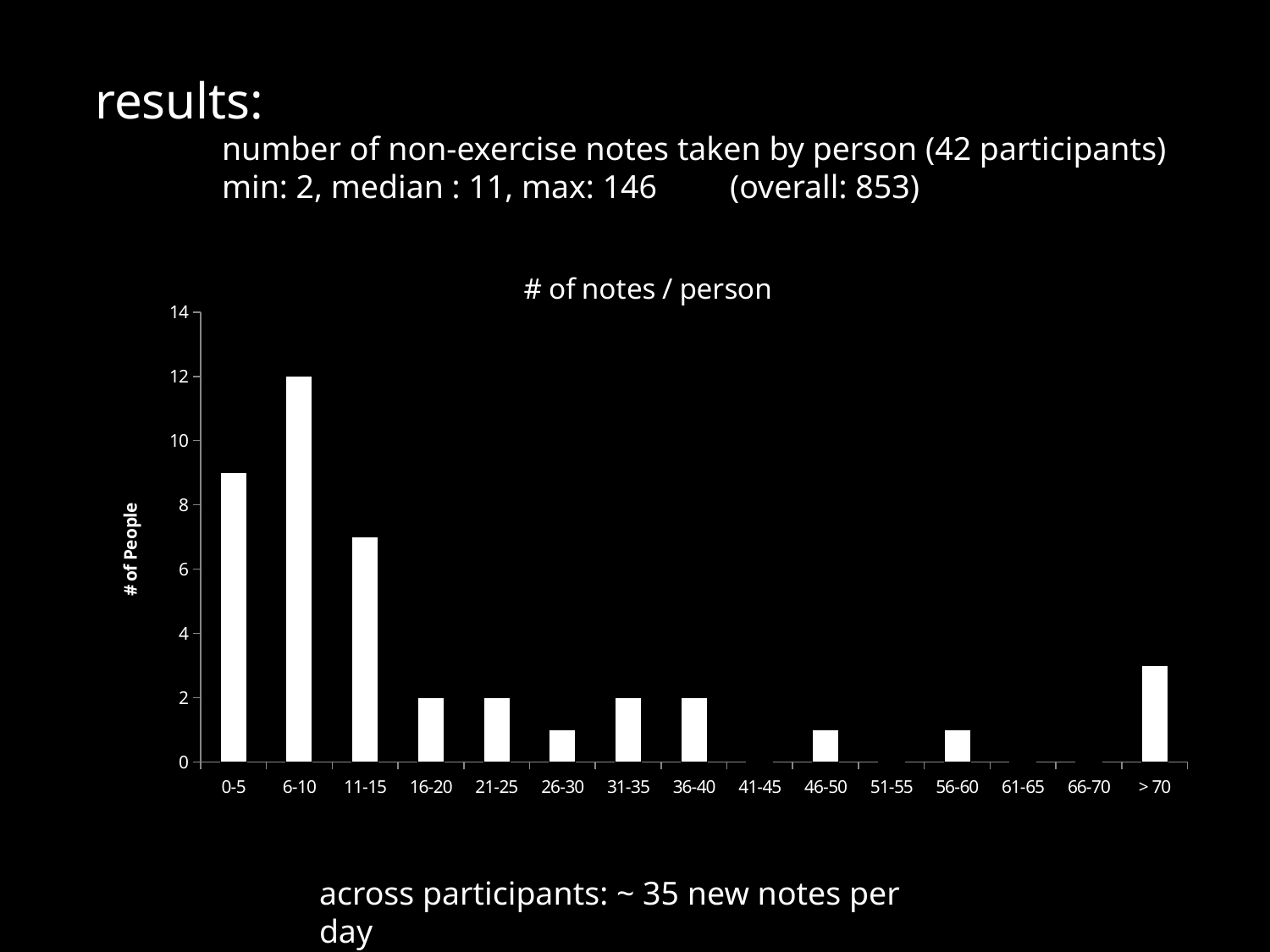
How many people are in the 6-10 category? 12 Is the value for the > 70 category greater or less than 2? greater How many people are in the 16-20 category? 2 What is the title of the chart? # of notes / person Is the value for the 11-15 category greater or less than 8? less Which category has more people, 0-5 or 11-15? 0-5 What is the label on the vertical axis of the chart? # of People Which category has the highest number of people? 6-10 How many people are in the 36-40 category? 2 Is the value for the 0-5 category greater or less than 8? greater How many categories are shown along the x axis of the chart? 15 What kind of chart is shown on the slide? bar chart